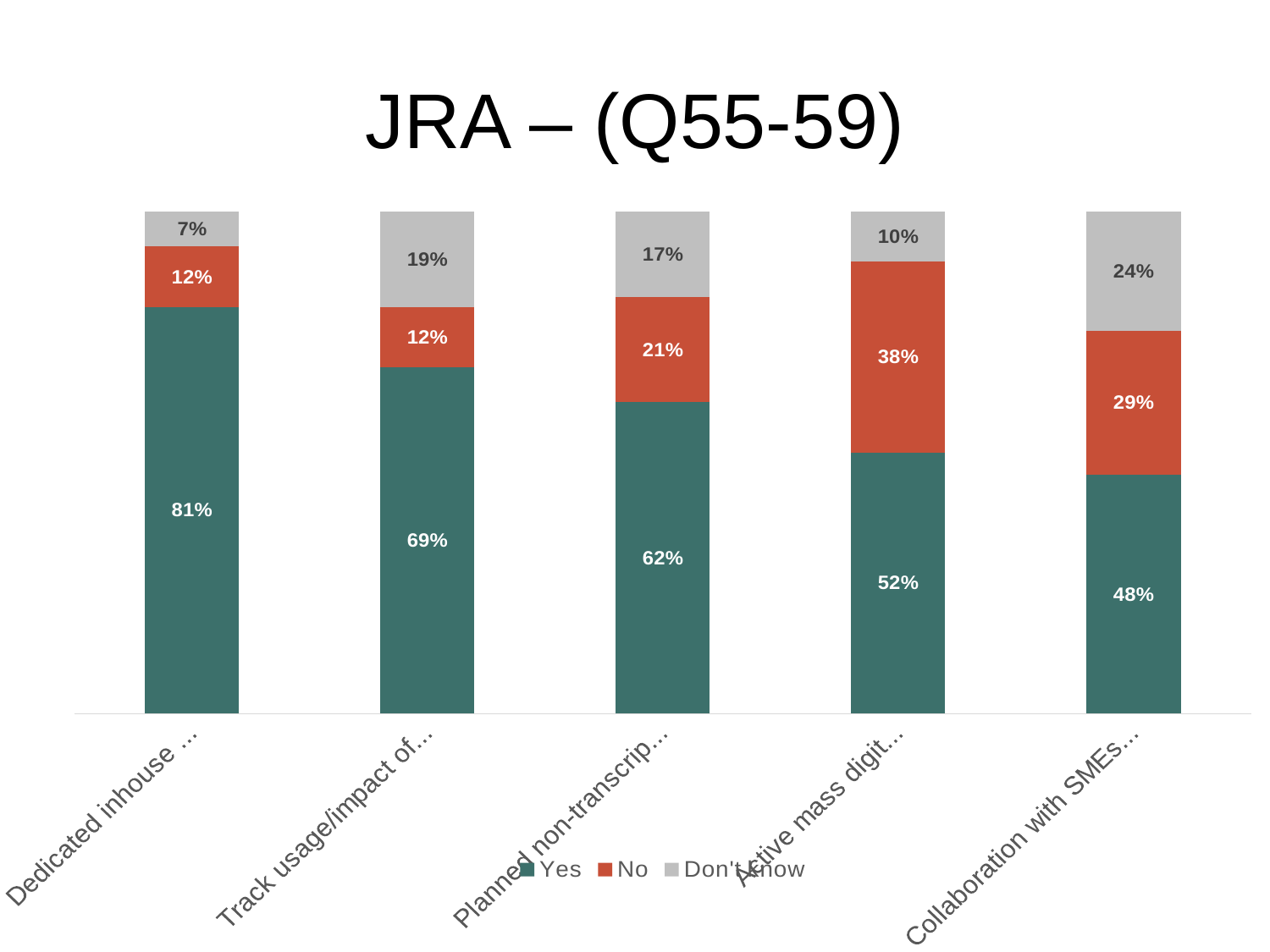
What is the 'Yes' value for the 'Dedicated inhouse' category? 81% Which category has the highest 'Yes' value? Dedicated inhouse What is the difference between the 'Yes' values for 'Track usage/impact of...' and 'Planned non-transcrip...'? 7% How many series does the legend list? 3 What is the 'Don't know' value for the 'Collaboration with SMEs' category? 24% How many categories are shown on the x axis? 5 Which is larger: the 'No' value for 'Collaboration with SMEs' or the 'No' value for 'Planned non-transcrip...'? Collaboration with SMEs What is the title of the chart? JRA – (Q55-59) Which category has the lowest 'Don't know' value? Dedicated inhouse What type of chart is shown on the slide? Stacked bar chart What is the 'No' value for the 'Active mass digit...' category? 38% Do the 'Yes' values rise or fall moving left to right across the categories? Fall